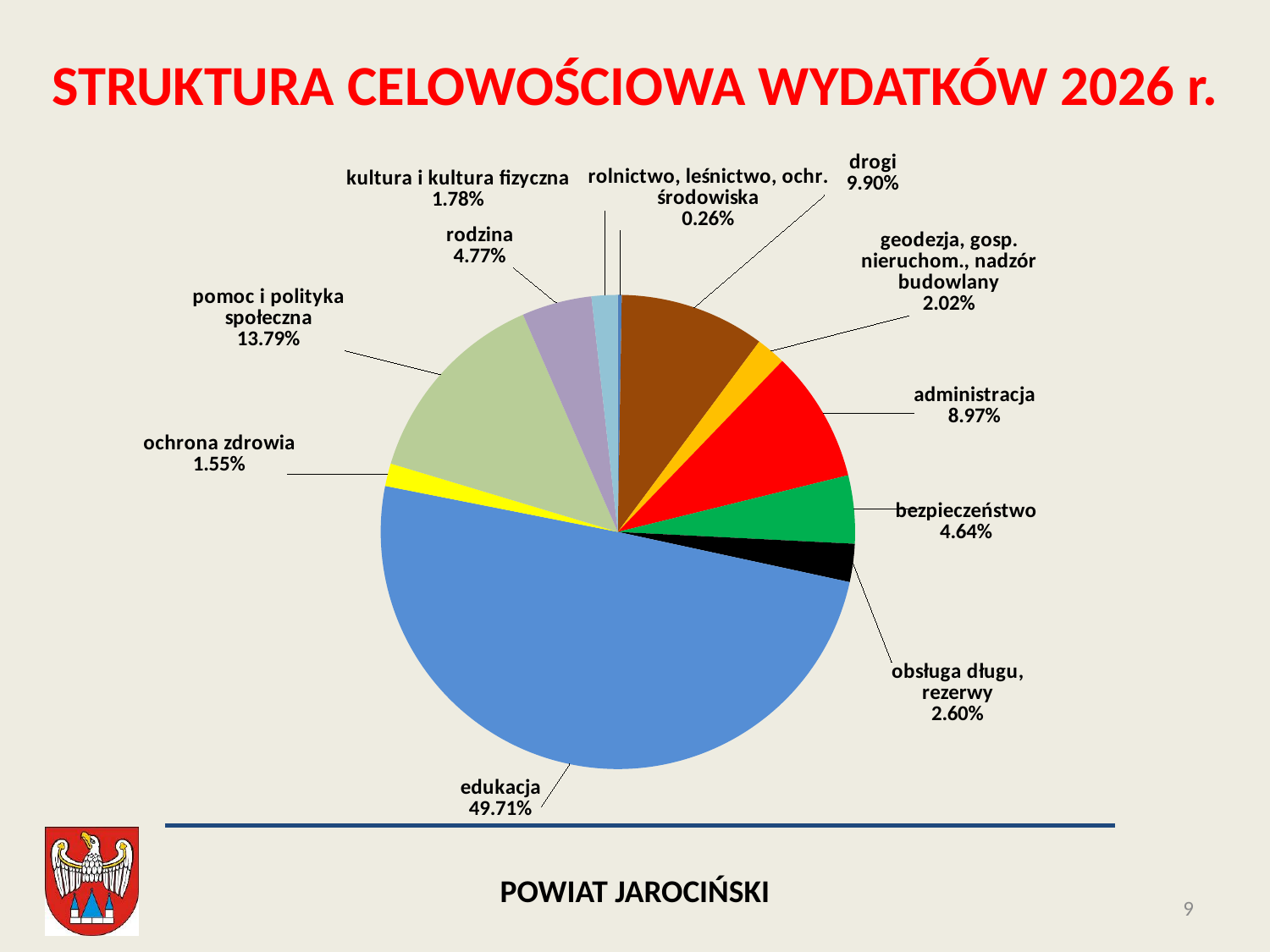
What is the title of the slide containing the chart? STRUKTURA CELOWOŚCIOWA WYDATKÓW 2026 r. Which category has the smallest slice of the pie? rolnictwo, leśnictwo, ochr. środowiska What is the difference in percentage points between administracja and bezpieczeństwo? 4.33 What kind of chart is shown on the slide? pie chart What is the difference in percentage points between drogi and geodezja, gosp. nieruchom., nadzór budowlany? 7.88 What share of expenditure is labelled for edukacja? 49.71% How many categories (slices) does the pie chart have? 11 Which is larger, the share for rodzina or the share for bezpieczeństwo? rodzina What percentage is shown for pomoc i polityka społeczna? 13.79% What percentage is shown for drogi? 9.90% What percentage is shown for rolnictwo, leśnictwo, ochr. środowiska? 0.26% Which category has the largest slice of the pie? edukacja